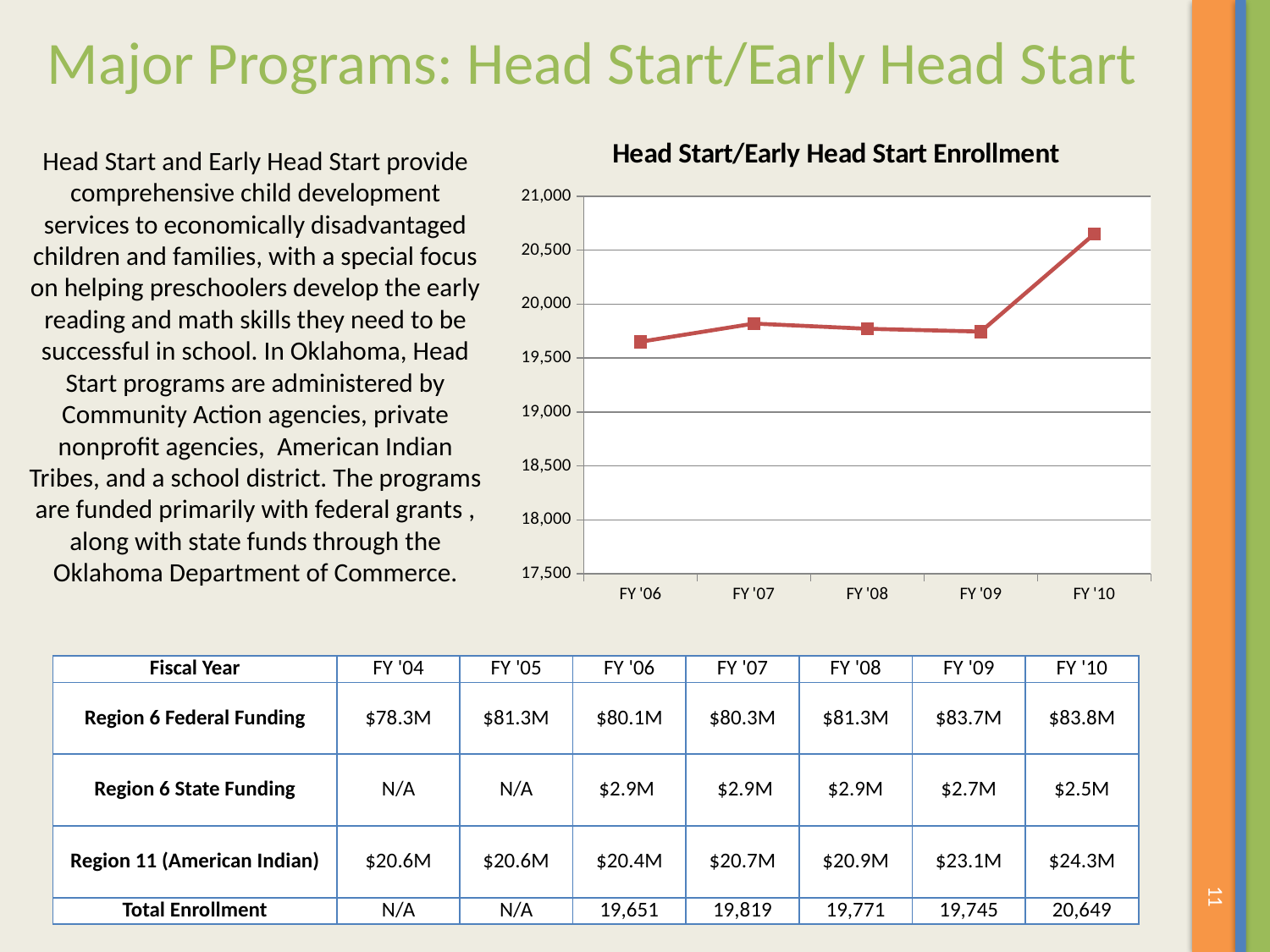
Which fiscal year has the lowest enrollment on the chart? FY '06 Is the enrollment for FY '10 larger or smaller than the enrollment for FY '09? larger Is the enrollment value for FY '10 greater or less than 20,500? greater What is the title of the chart? Head Start/Early Head Start Enrollment According to the Total Enrollment row of the table, what is the enrollment plotted for FY '10? 20,649 Which fiscal year has the highest enrollment on the chart? FY '10 How many fiscal years are plotted on the chart? 5 Does the enrollment rise or fall between FY '09 and FY '10? rise Is the enrollment value for FY '06 greater or less than 19,500? greater Using the Total Enrollment values in the table, what is the difference between FY '10 and FY '06 enrollment? 998 Is the enrollment value for FY '09 greater or less than 20,000? less What kind of chart is shown on the slide? line chart